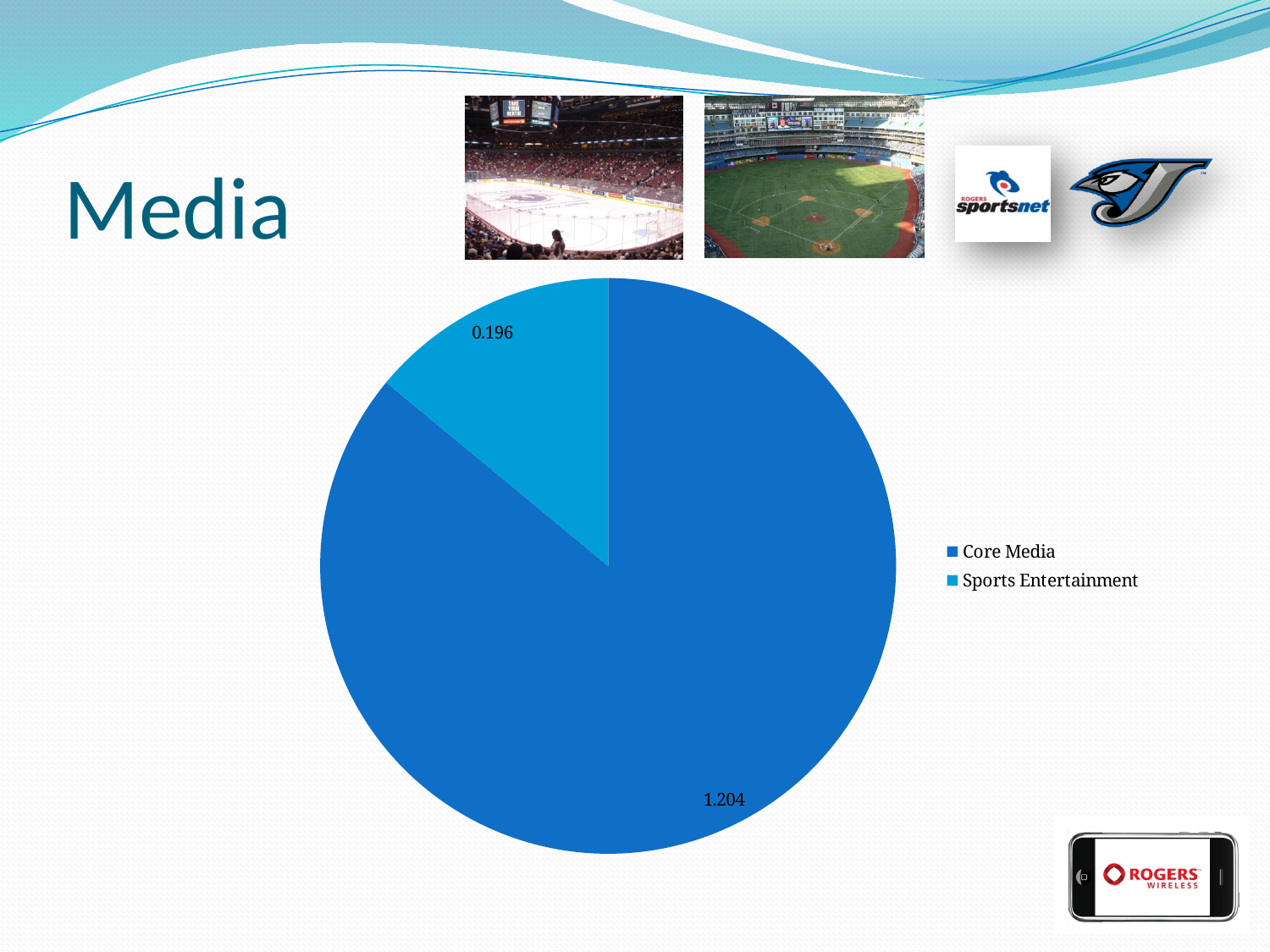
What share of the pie does Core Media represent? 86% Which slice of the pie chart is the largest? Core Media What is the difference between the Core Media value and the Sports Entertainment value? 1.008 What is the value for Core Media in the pie chart? 1.204 Which slice of the pie chart is the smallest? Sports Entertainment How many slices does the pie chart have? 2 What kind of chart is shown on the slide? pie chart Which is larger, Core Media or Sports Entertainment? Core Media How many entries does the legend list? 2 What is the total of all slices in the pie chart? 1.400 What is the value for Sports Entertainment in the pie chart? 0.196 What is the title of the slide containing the pie chart? Media